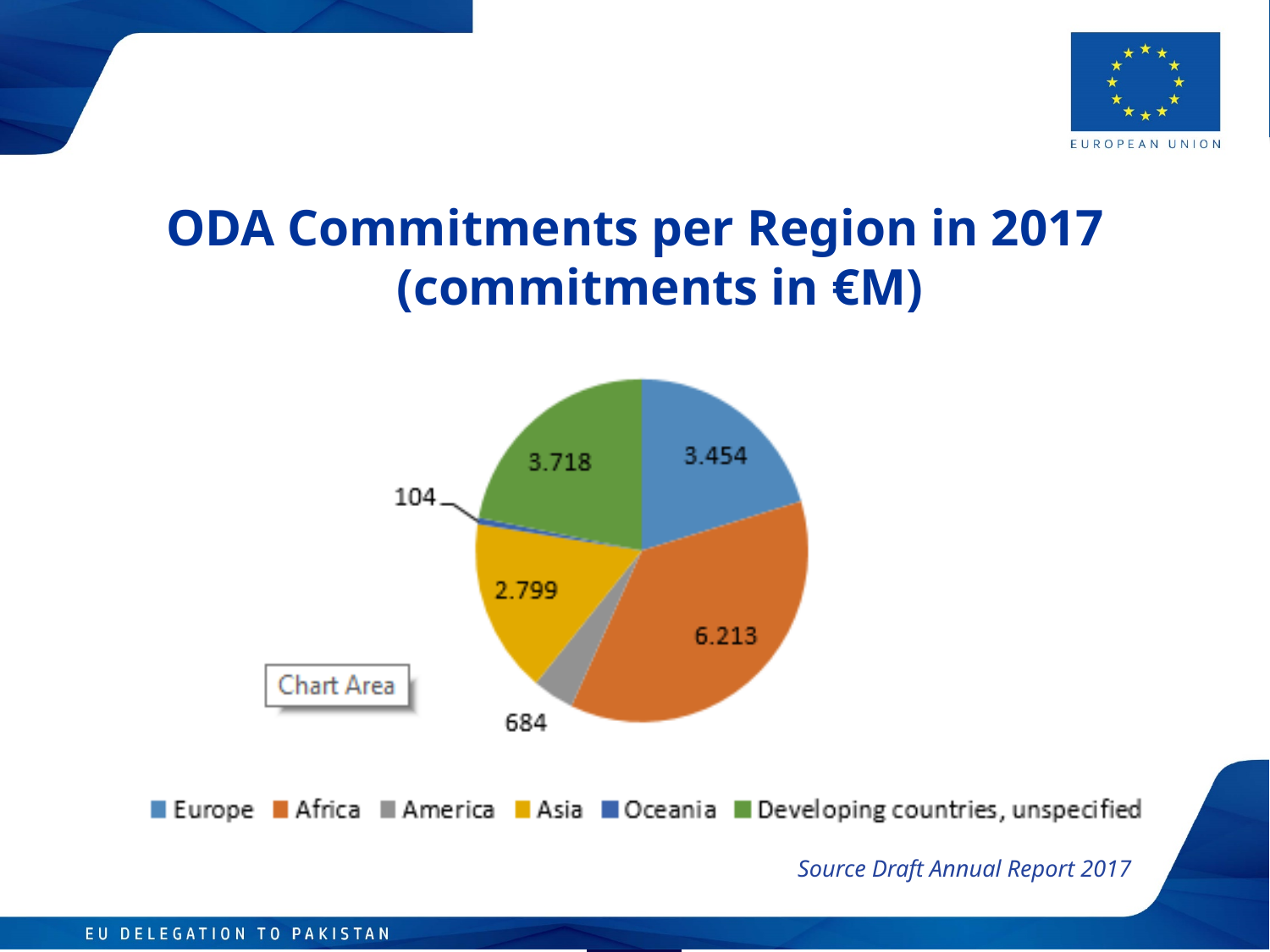
What is the difference between the value for Developing countries, unspecified and the value for Asia? 919 What is the value for Europe in the pie chart? 3.454 What is the value for Asia in the pie chart? 2.799 What is the value for Oceania in the pie chart? 104 How many slices does the pie chart have? 6 What is the value for America in the pie chart? 684 What is the value for Africa in the pie chart? 6.213 Which region has the largest ODA commitment in the pie chart? Africa Which region has the smallest ODA commitment in the pie chart? Oceania What kind of chart is shown on the slide? Pie chart What is the title of the chart on the slide? ODA Commitments per Region in 2017 (commitments in €M) Which is larger, the value for Europe or the value for Developing countries, unspecified? Developing countries, unspecified